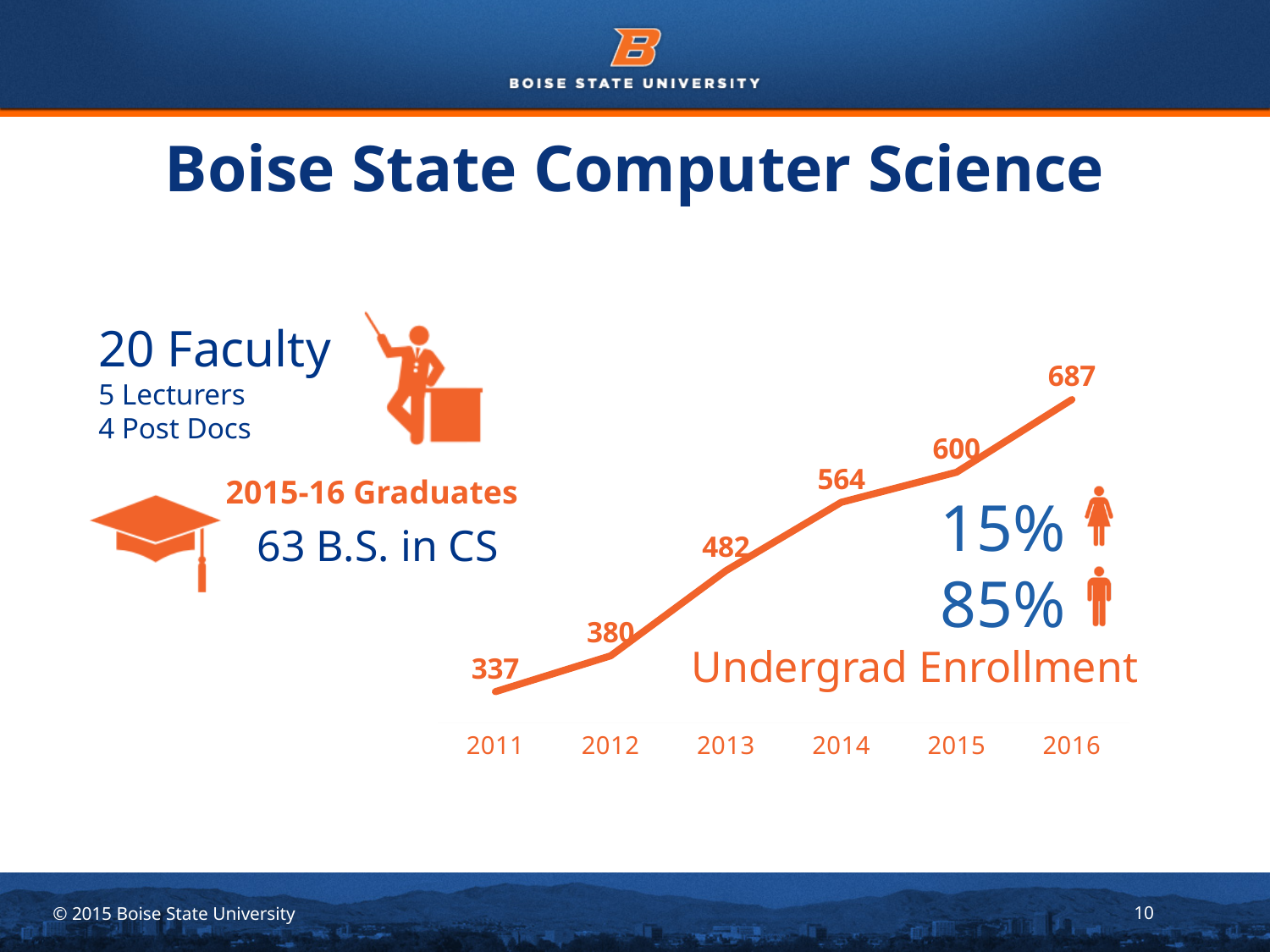
How many years are plotted on the undergrad enrollment chart? 6 What is the undergrad enrollment value for 2011? 337 What kind of chart is used to show undergrad enrollment? line chart What colour is the undergrad enrollment line? orange What is the difference in undergrad enrollment between 2013 and 2012? 102 Does undergrad enrollment rise or fall from 2011 to 2016? rise Which year has higher undergrad enrollment, 2013 or 2015? 2015 Which year has the lowest undergrad enrollment? 2011 What is the undergrad enrollment value for 2014? 564 What is the difference in undergrad enrollment between 2016 and 2011? 350 What is the undergrad enrollment value for 2016? 687 Which year has the highest undergrad enrollment? 2016